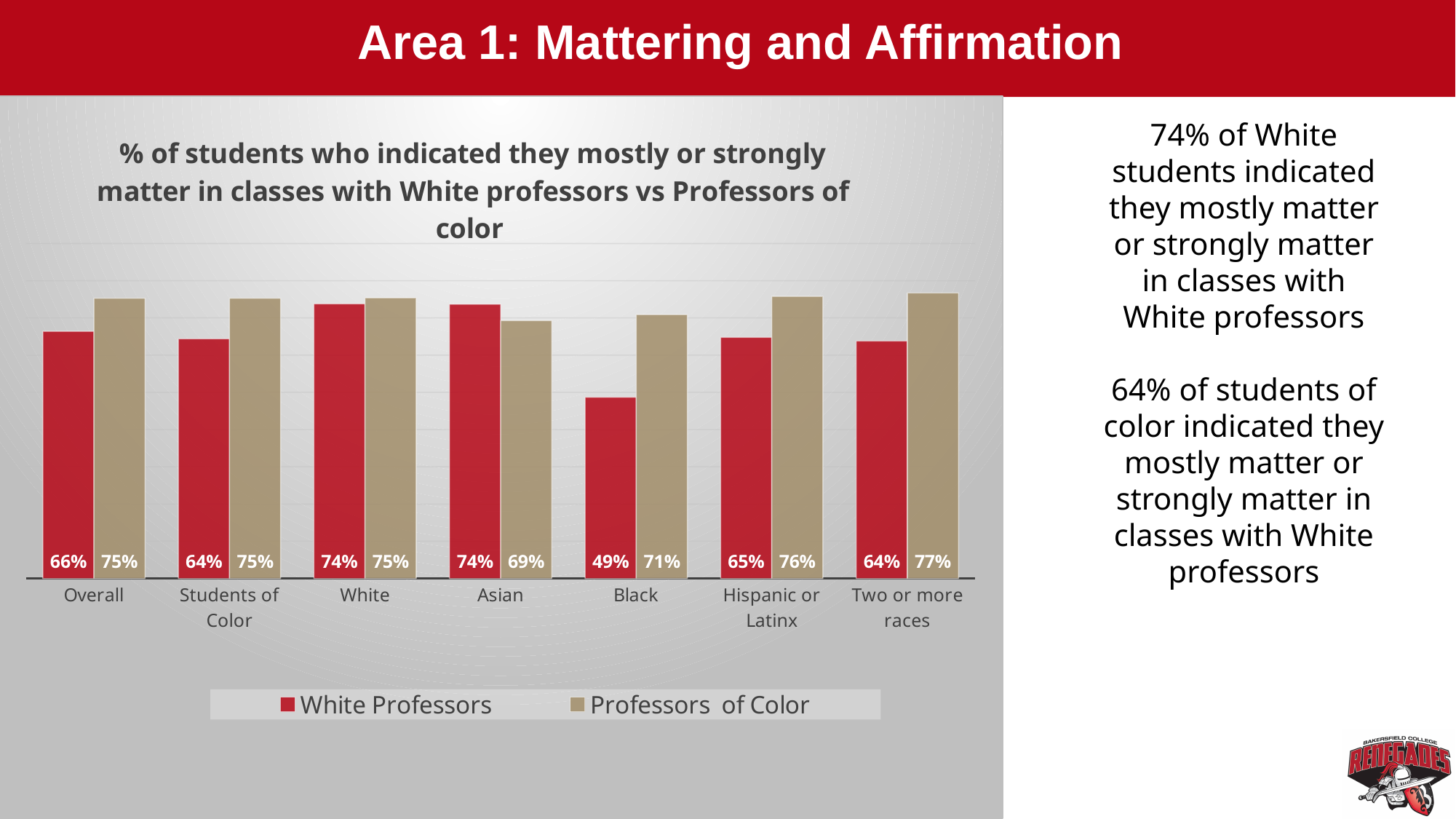
For Asian students, which is larger: the White Professors value or the Professors of Color value? White Professors Which category has the highest value for Professors of Color? Two or more races What is the difference between the Hispanic or Latinx values for Professors of Color and White Professors? 11% What kind of chart is shown on the slide? Bar chart What is the difference between the Professors of Color and White Professors values for Black students? 22% How many categories are shown on the x axis? 7 What percentage of Black students indicated they mostly or strongly matter in classes with White professors? 49% How many series does the legend list? 2 What is the value for Two or more races in the Professors of Color series? 77% Which category has the lowest value for White Professors? Black Which colour represents the White Professors series in the legend? Red What is the Overall value for Professors of Color? 75%